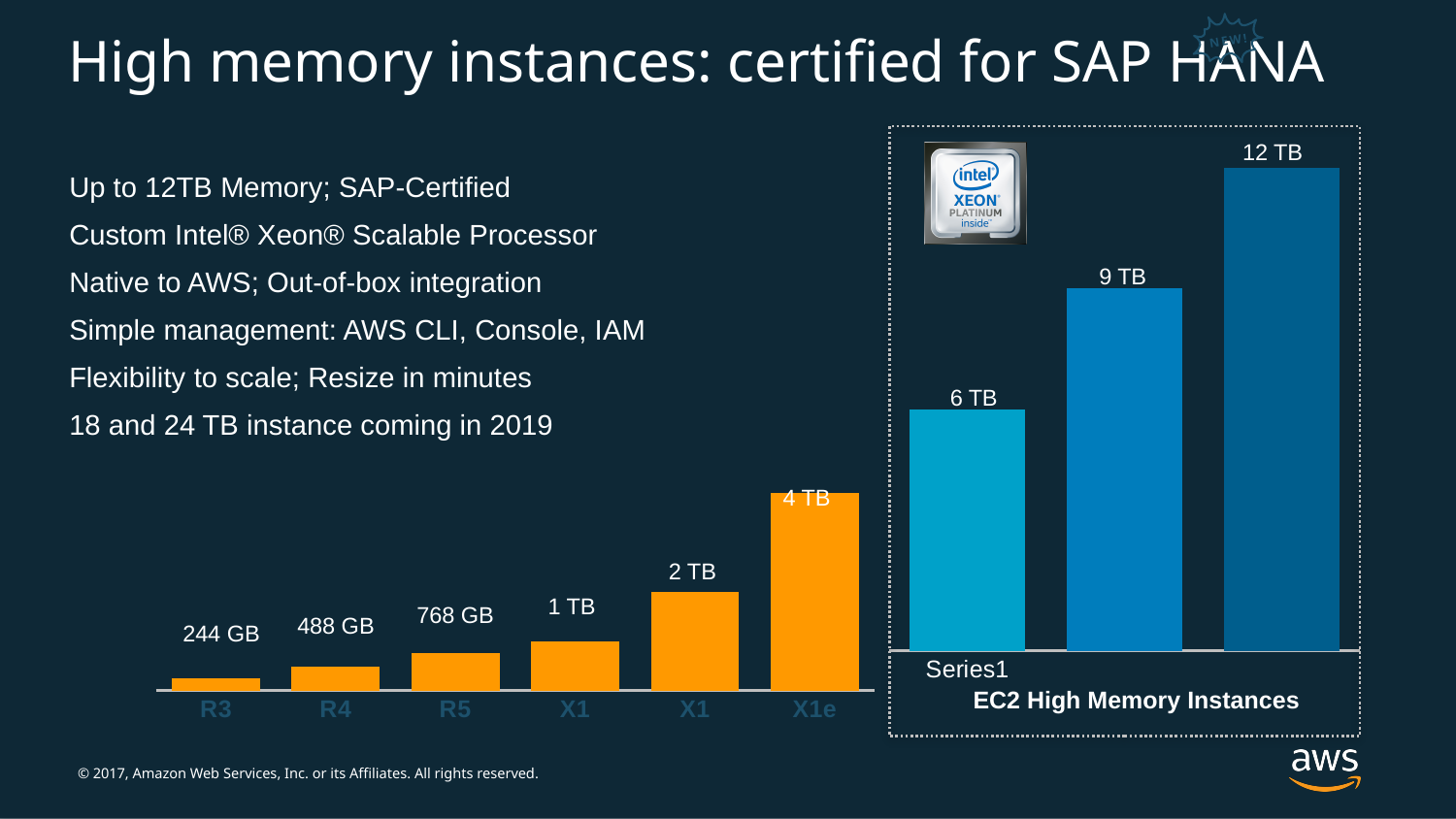
On the left orange bar chart, what is the difference between the values for R4 and R3? 244 GB On the chart titled EC2 High Memory Instances, what is the highest value shown? 12 TB On the left orange bar chart, which category has the highest value? X1e On the left orange bar chart, which category has the lowest value? R3 On the left orange bar chart, what is the value for X1e? 4 TB On the left orange bar chart, which is larger, the value for R5 or the value for R4? R5 On the left orange bar chart, do the values rise or fall from left to right? rise What kind of chart is the EC2 High Memory Instances chart? bar chart On the left orange bar chart, how many bars are plotted? 6 On the chart titled EC2 High Memory Instances, what is the difference between the largest and smallest bars? 6 TB On the left orange bar chart, what is the value for R3? 244 GB On the left orange bar chart, what is the value for R5? 768 GB